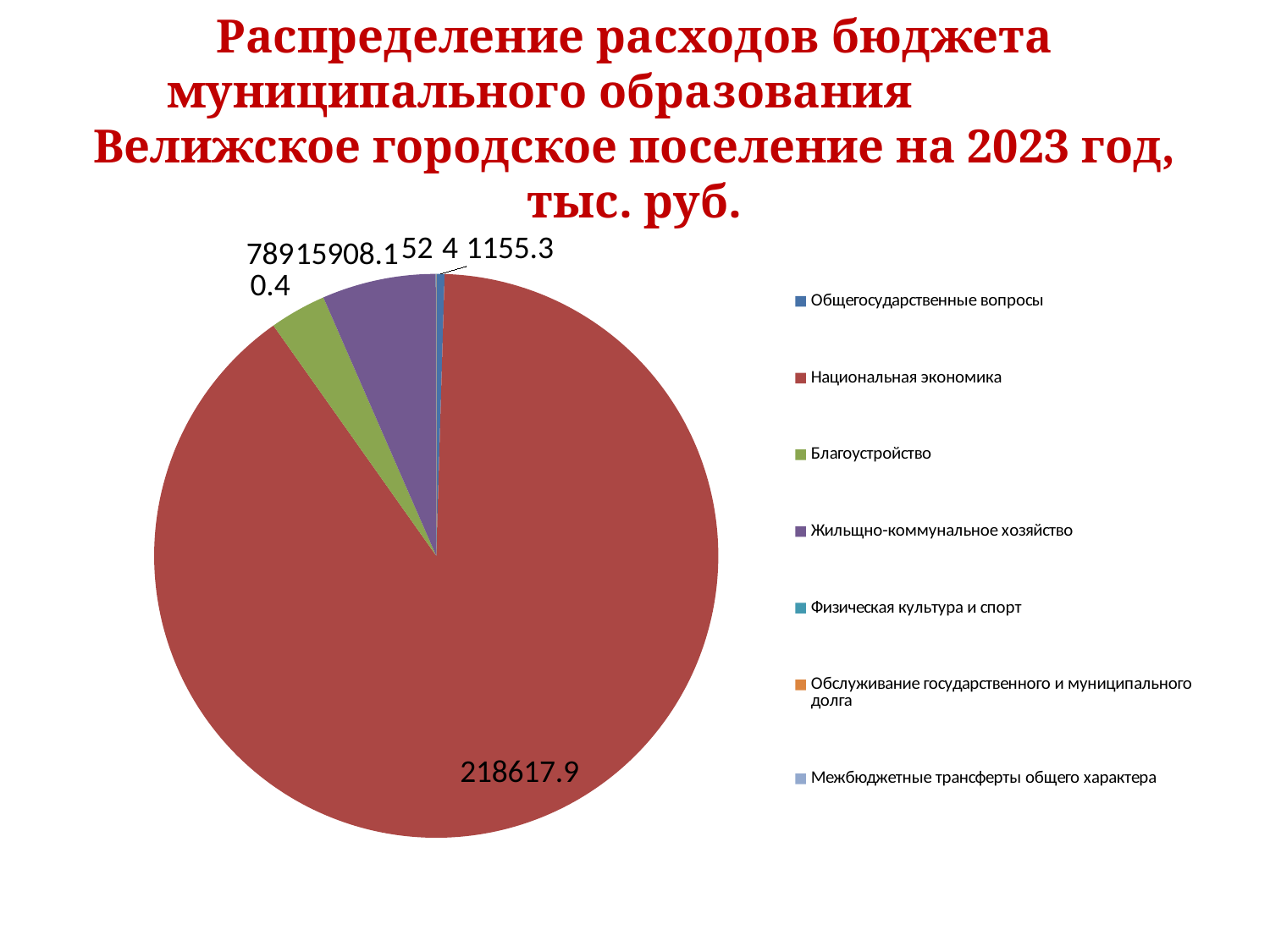
Which is larger in the pie chart: Жильщно-коммунальное хозяйство or Благоустройство? Жильщно-коммунальное хозяйство Which category has the largest slice in the pie chart? Национальная экономика What type of chart is shown on the slide? pie chart Which is larger in the pie chart: Национальная экономика or Благоустройство? Национальная экономика Which is larger in the pie chart: Национальная экономика or Жильщно-коммунальное хозяйство? Национальная экономика In what units are the values in the chart expressed, according to the title? тыс. руб. How many categories does the legend of the pie chart list? 7 For which year does the chart show the distribution of budget expenditures? 2023 What value is shown for Национальная экономика in the pie chart? 218617.9